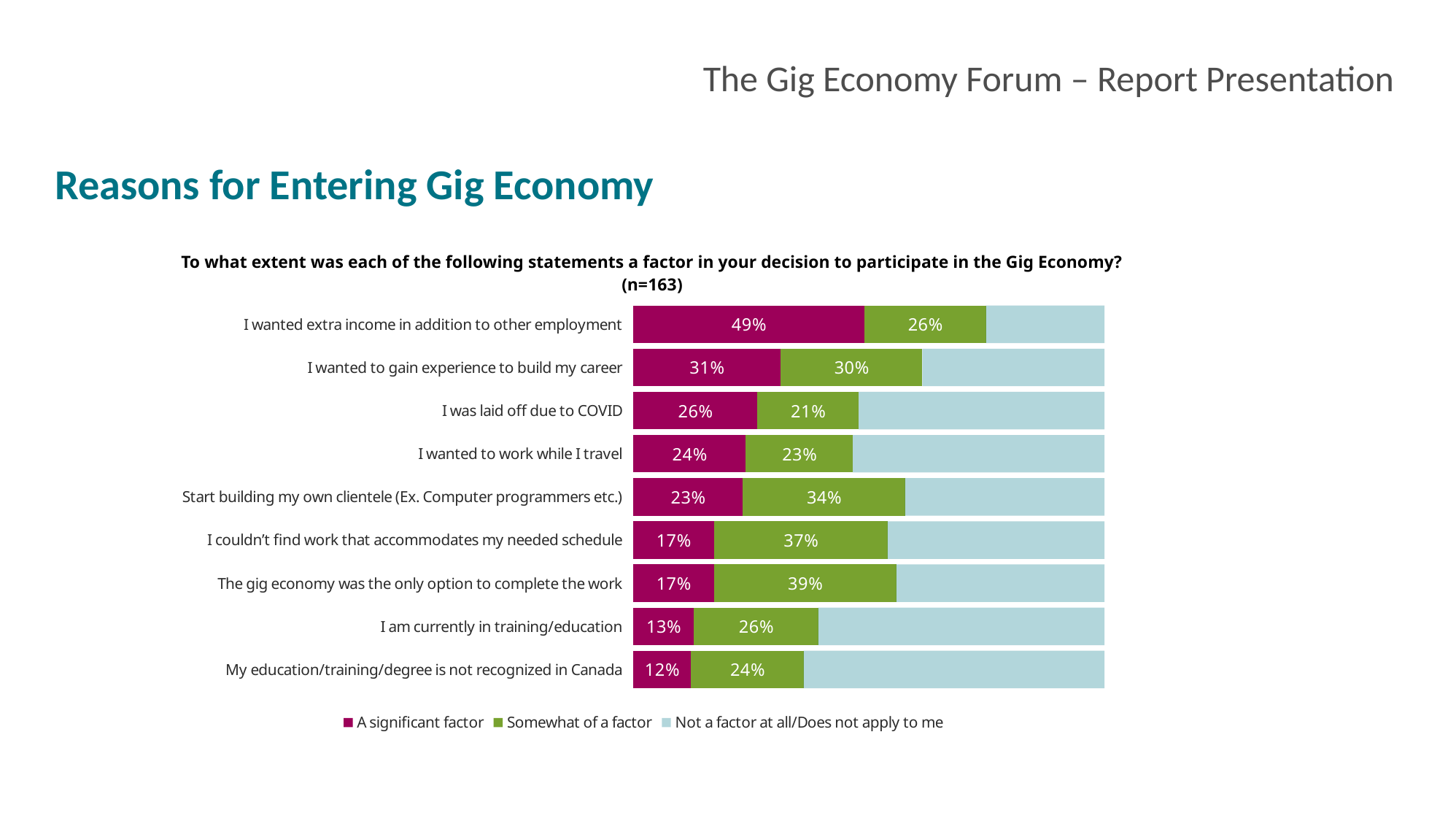
How many statements are shown in the chart? 9 What percentage said 'I wanted extra income in addition to other employment' was a significant factor? 49% Which statement has the highest percentage for 'A significant factor'? I wanted extra income in addition to other employment Which statement has the lowest percentage for 'A significant factor'? My education/training/degree is not recognized in Canada What percentage said 'The gig economy was the only option to complete the work' was somewhat of a factor? 39% Which statement has the highest percentage for 'Somewhat of a factor'? The gig economy was the only option to complete the work How many series does the legend list? 3 What is the difference between the 'A significant factor' percentages for 'I wanted extra income in addition to other employment' and 'I wanted to gain experience to build my career'? 18% What type of chart is shown on the slide? Stacked bar chart Which is larger: the 'Somewhat of a factor' value for 'Start building my own clientele' or for 'I couldn't find work that accommodates my needed schedule'? I couldn't find work that accommodates my needed schedule What percentage said 'I was laid off due to COVID' was somewhat of a factor? 21% What is the sample size (n) shown in the chart title? 163